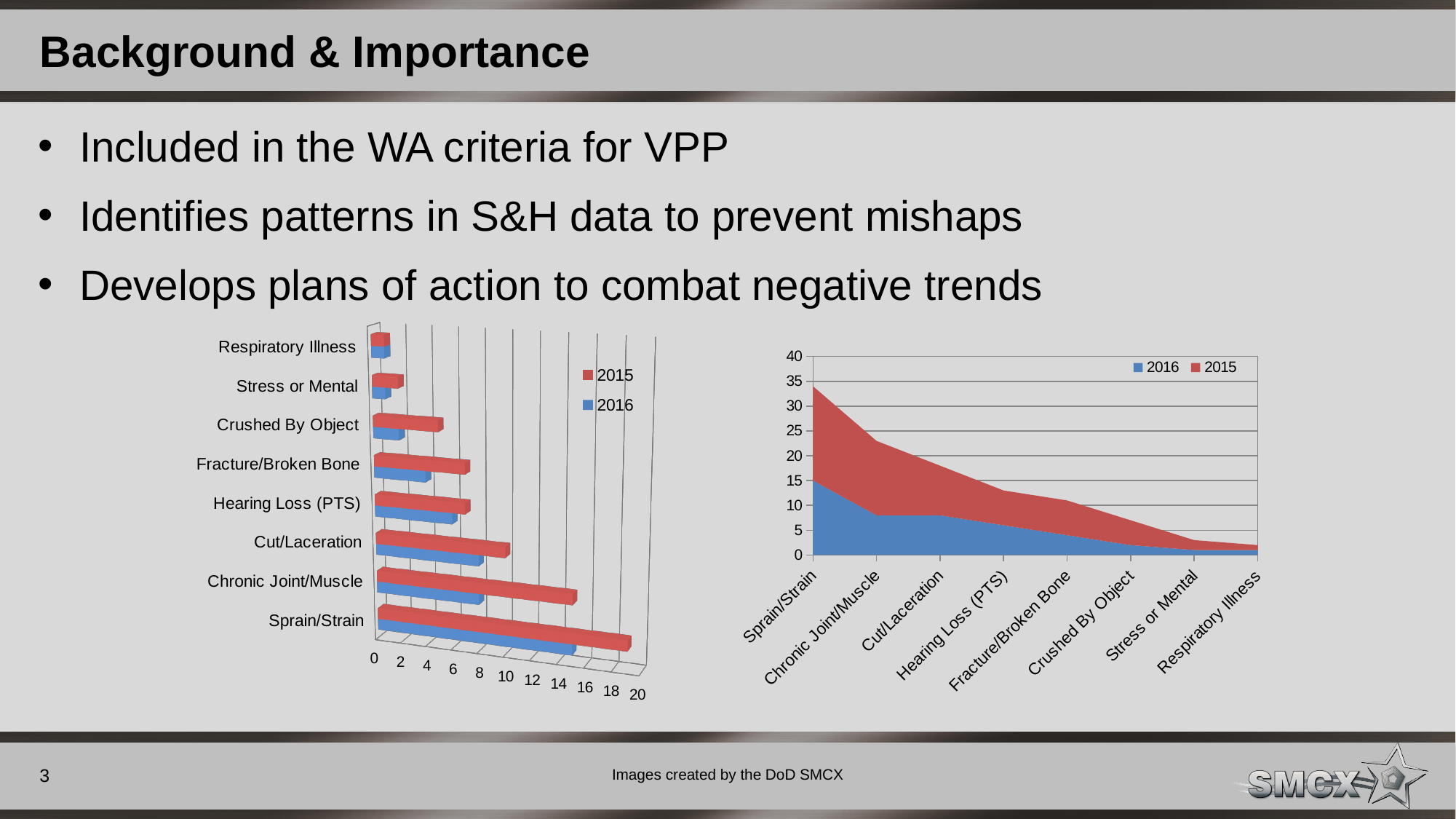
In the area chart on the right, do the values rise or fall moving from Sprain/Strain to Respiratory Illness along the x axis? Fall What kind of chart is the chart on the left of the slide? Bar chart In the bar chart on the left, how many series does the legend list? 2 In the bar chart on the left, is the 2015 value for Respiratory Illness greater or less than 4? less In the area chart on the right, is the stacked total for Sprain/Strain greater or less than 30? greater In the bar chart on the left, which category has the longest 2015 bar? Sprain/Strain In the bar chart on the left, which is larger for Chronic Joint/Muscle, the 2015 value or the 2016 value? 2015 In the bar chart on the left, how many categories are shown? 8 In the bar chart on the left, which category has the shortest 2015 bar? Respiratory Illness In the bar chart on the left, is the 2015 value for Sprain/Strain greater or less than 16? greater What kind of chart is the chart on the right of the slide? Area chart In the area chart on the right, which series is shown in red? 2015